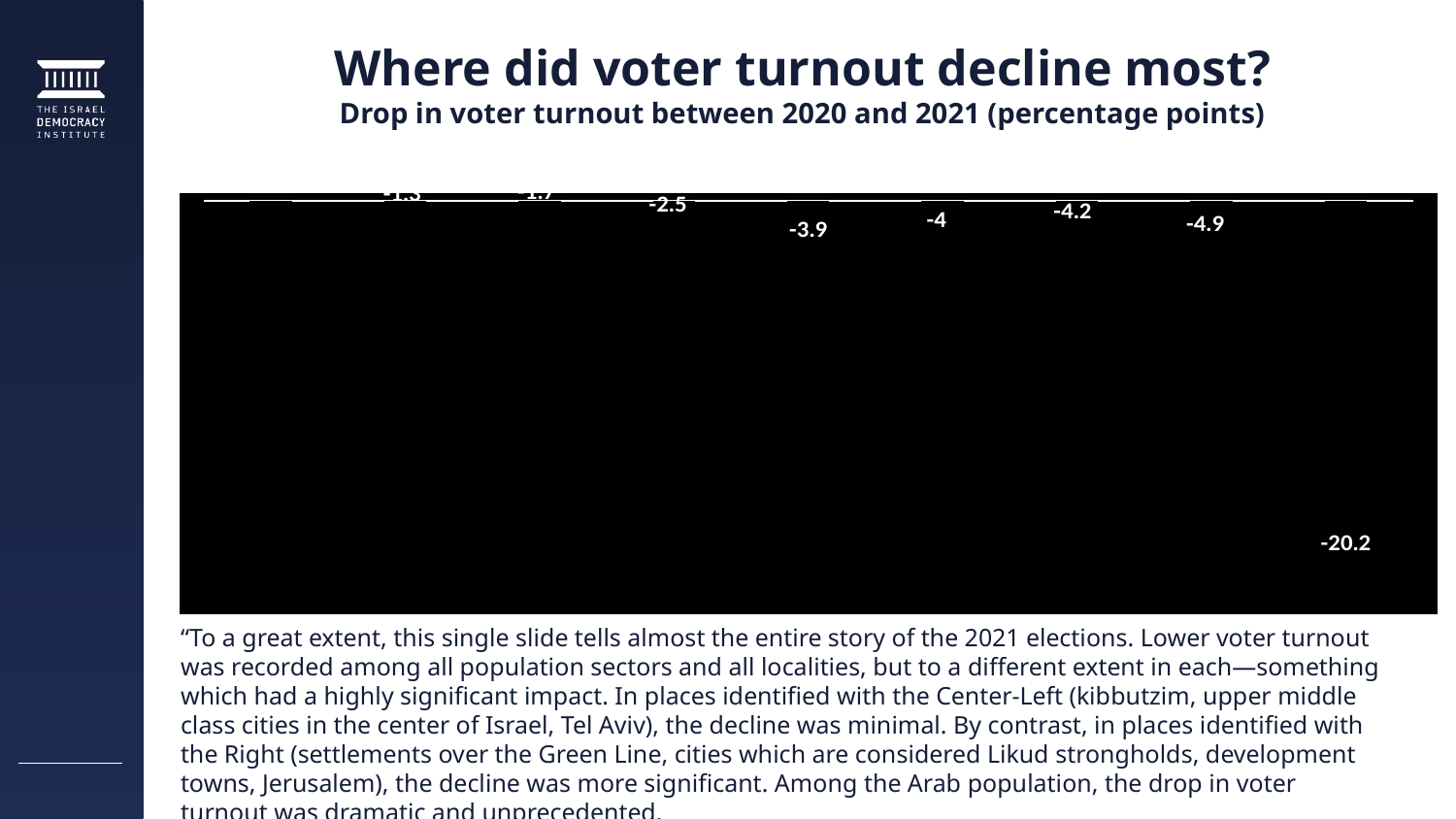
In what units are the values on the chart expressed? percentage points What is the largest drop in voter turnout shown on the chart? -20.2 Which data label on the chart represents a bigger drop, -3.9 or -4.2? -4.2 What is the difference between the data labels -4.9 and -20.2 on the chart? 15.3 What is the subtitle describing the chart's data? Drop in voter turnout between 2020 and 2021 (percentage points)